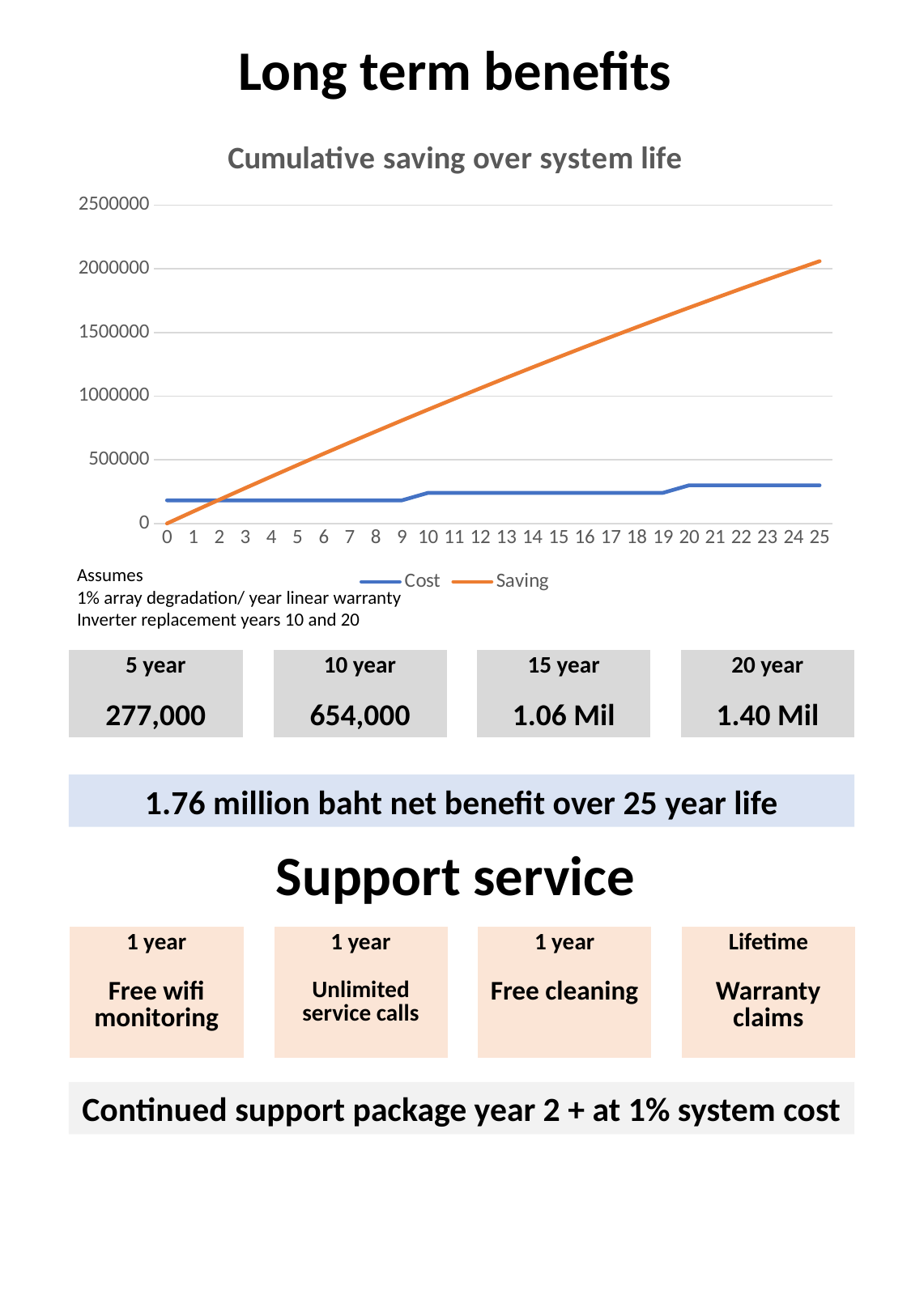
At year 25, which series has the larger value, Cost or Saving? Saving Is the Saving value at year 15 greater or less than 1000000? greater How many year points are shown along the x axis of the chart? 26 What is the title of the chart? Cumulative saving over system life Is the Cost value at year 25 greater or less than 500000? less Is the Saving value at year 10 greater or less than 1000000? less What kind of chart is shown on the slide? line chart At year 0, which series has the larger value, Cost or Saving? Cost Which series is drawn in orange? Saving Does the Saving series rise or fall as the years increase along the x axis? rise How many series does the chart legend list? 2